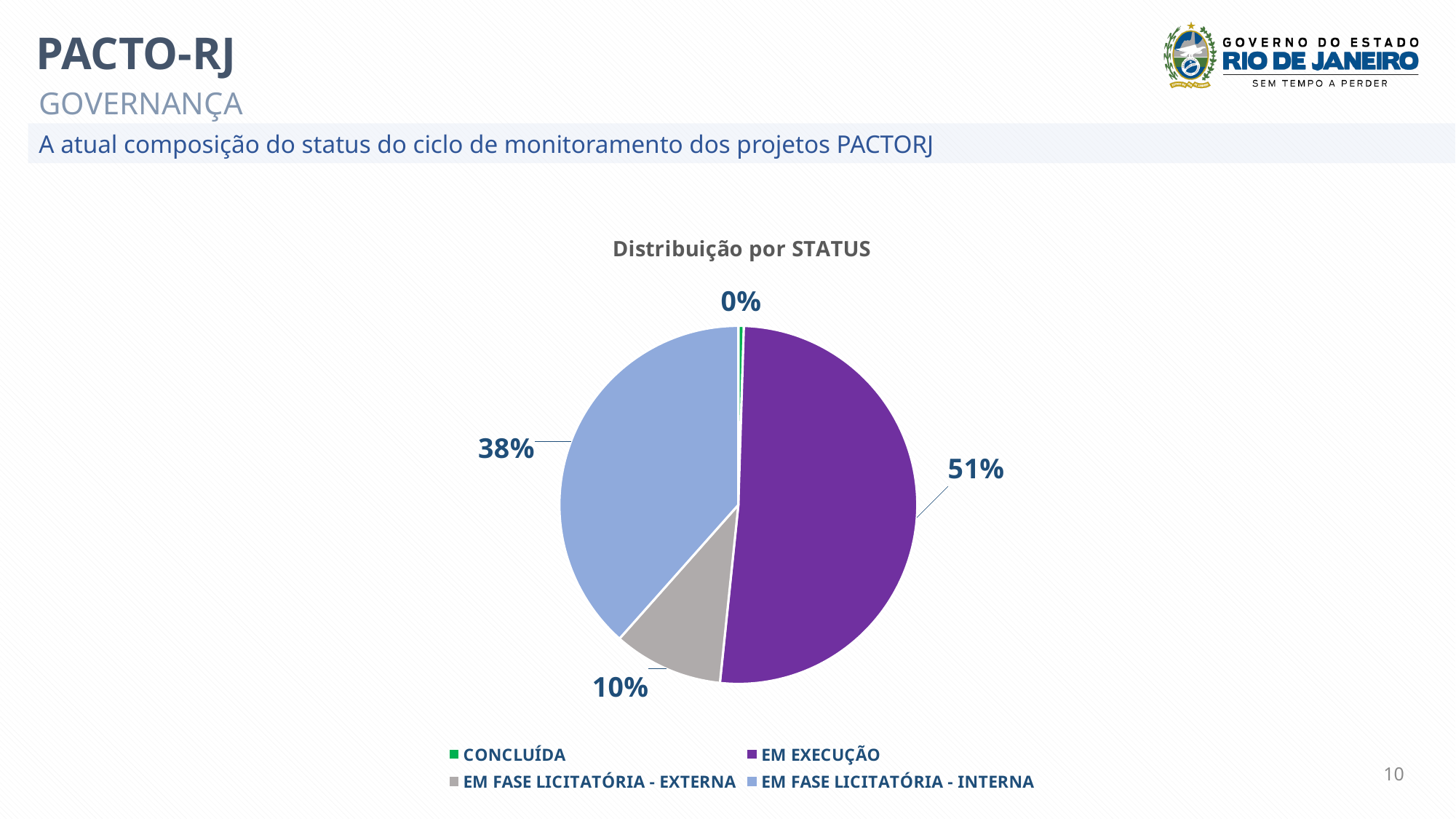
What is the title of the chart? Distribuição por STATUS Which status has the smallest share of the pie? CONCLUÍDA What percentage of the pie is EM FASE LICITATÓRIA - INTERNA? 38% What percentage of the pie is EM EXECUÇÃO? 51% What type of chart is shown on the slide? Pie chart What percentage of the pie is EM FASE LICITATÓRIA - EXTERNA? 10% What is the difference in percentage points between EM EXECUÇÃO and EM FASE LICITATÓRIA - INTERNA? 13% Which status has the largest share of the pie? EM EXECUÇÃO Which is larger: EM FASE LICITATÓRIA - INTERNA or EM FASE LICITATÓRIA - EXTERNA? EM FASE LICITATÓRIA - INTERNA How many categories does the legend list? 4 What percentage of the pie is CONCLUÍDA? 0% What colour represents EM EXECUÇÃO in the pie chart? Purple